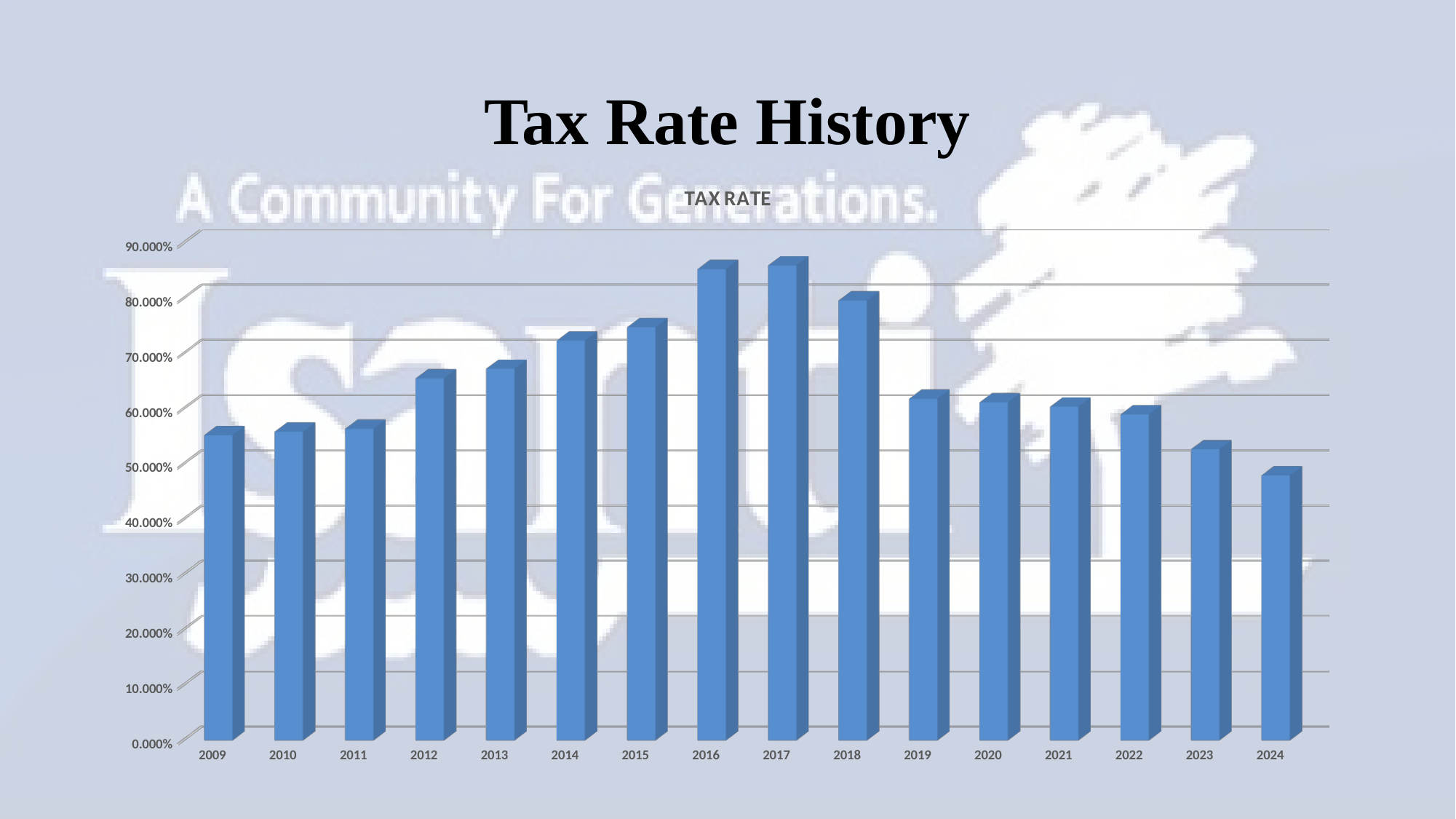
Which year has the higher tax rate, 2019 or 2024? 2019 Is the tax rate for 2016 greater or less than 80.000%? greater How many years are plotted on the x axis of the chart? 16 Is the tax rate for 2014 greater or less than 70.000%? greater Which year has the lowest tax rate in the chart? 2024 Is the tax rate for 2012 greater or less than 60.000%? greater Do the tax rates rise or fall from 2017 to 2024? fall What kind of chart is shown on the slide? bar chart What is the title printed above the chart's plot area? TAX RATE Which year has the higher tax rate, 2016 or 2009? 2016